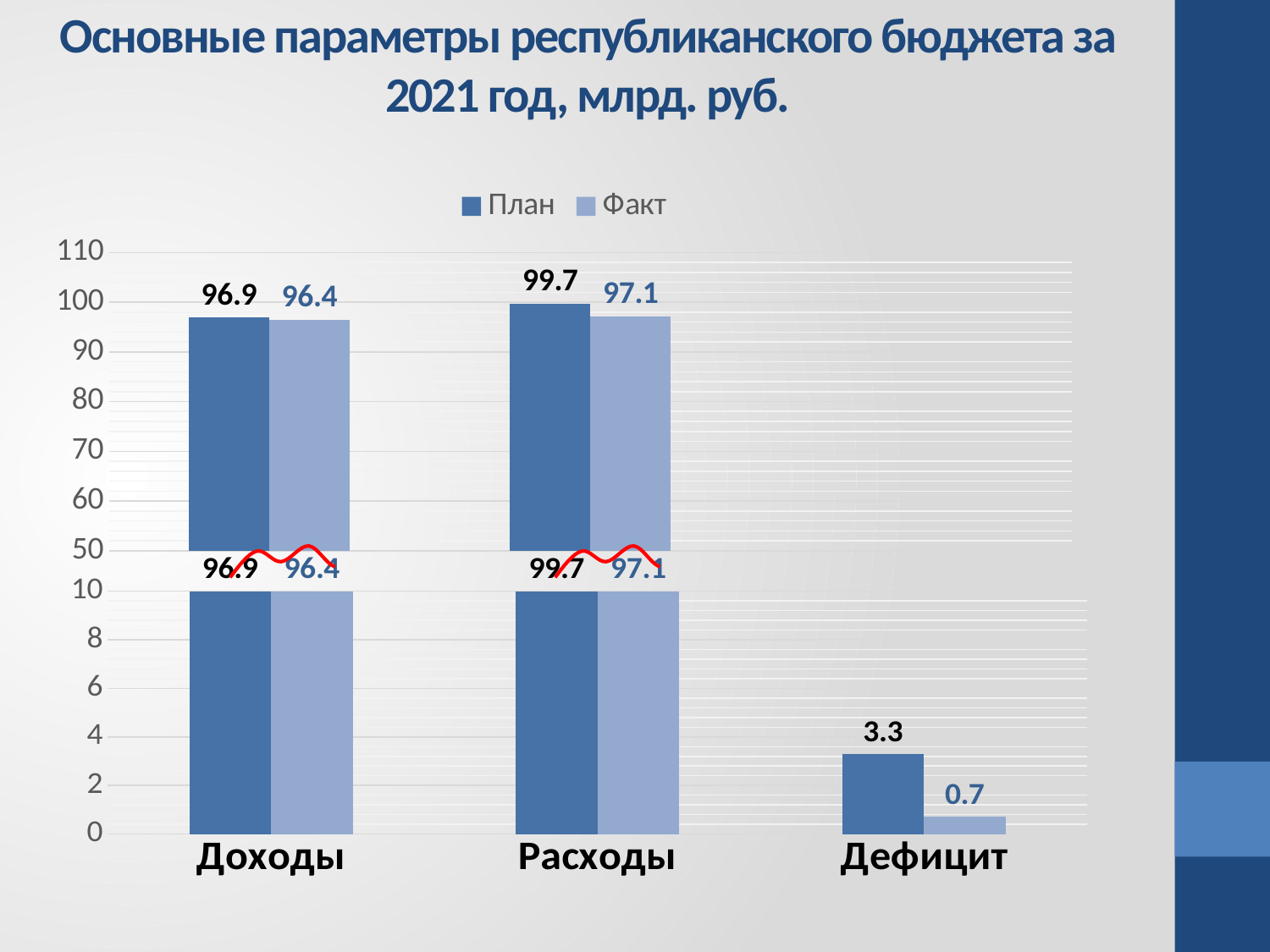
What kind of chart is shown on the slide? Bar chart Which is larger for Доходы, the План value or the Факт value? План How many series does the legend list? 2 Which category has the highest План value? Расходы What is the difference between the План and Факт values for Расходы? 2.6 What is the План value for Расходы? 99.7 What is the Факт value for Доходы? 96.4 What is the План value for Дефицит? 3.3 Which category has the lowest Факт value? Дефицит What is the difference between the План and Факт values for Дефицит? 2.6 What is the Факт value for Дефицит? 0.7 How many categories are shown on the x axis? 3